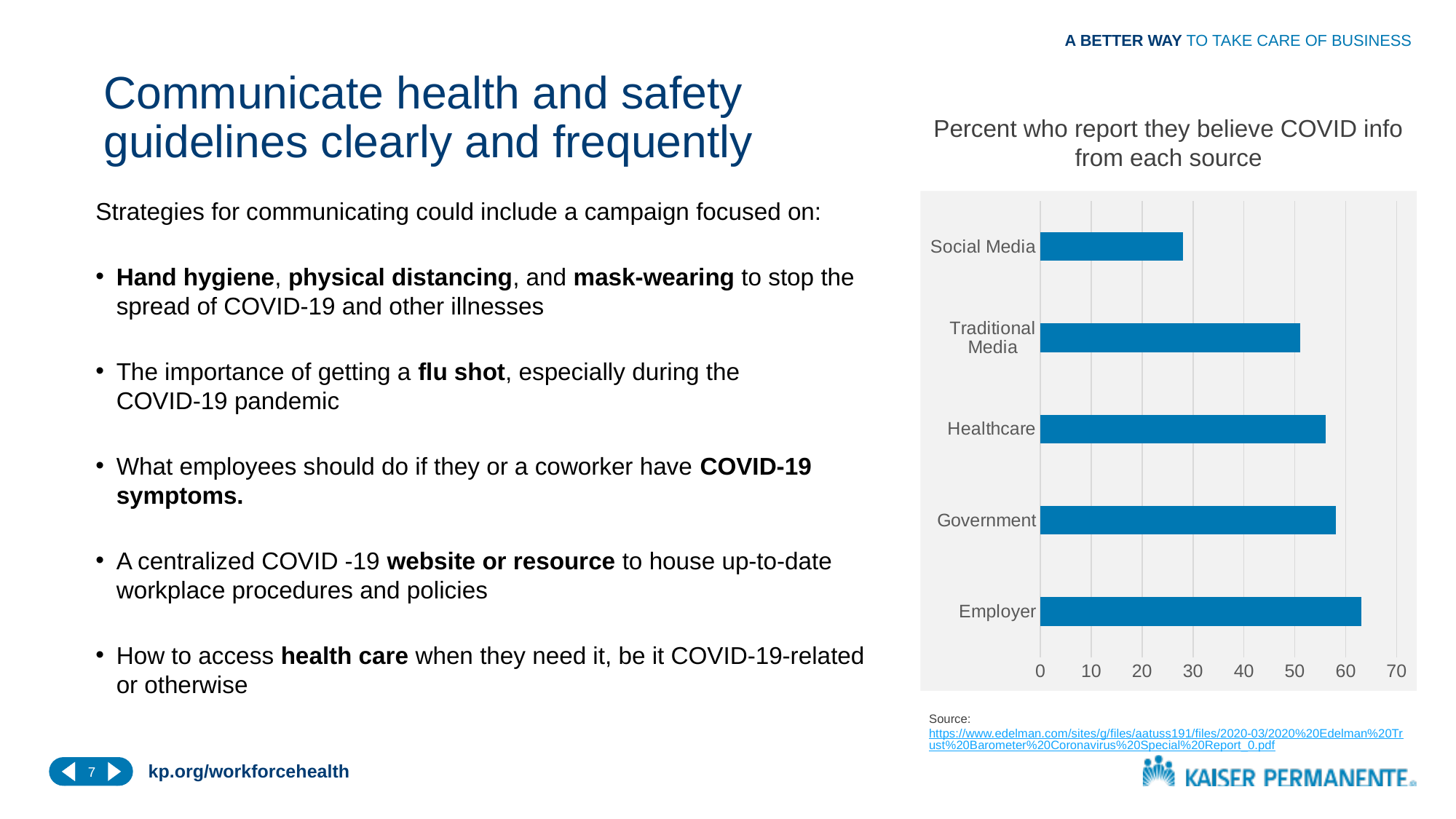
Which source has the lowest percent of people who believe COVID info from it? Social Media Which source has the highest percent of people who believe COVID info from it? Employer Is the value for Employer greater or less than 60? greater Which is larger, the value for Traditional Media or the value for Social Media? Traditional Media What kind of chart is shown on the slide? Bar chart Is the value for Traditional Media greater or less than 40? greater Is the value for Healthcare greater or less than 50? greater How many sources (categories) are shown in the chart? 5 What is the title of the chart? Percent who report they believe COVID info from each source Which is larger, the value for Employer or the value for Social Media? Employer What is the maximum value shown on the horizontal axis of the chart? 70